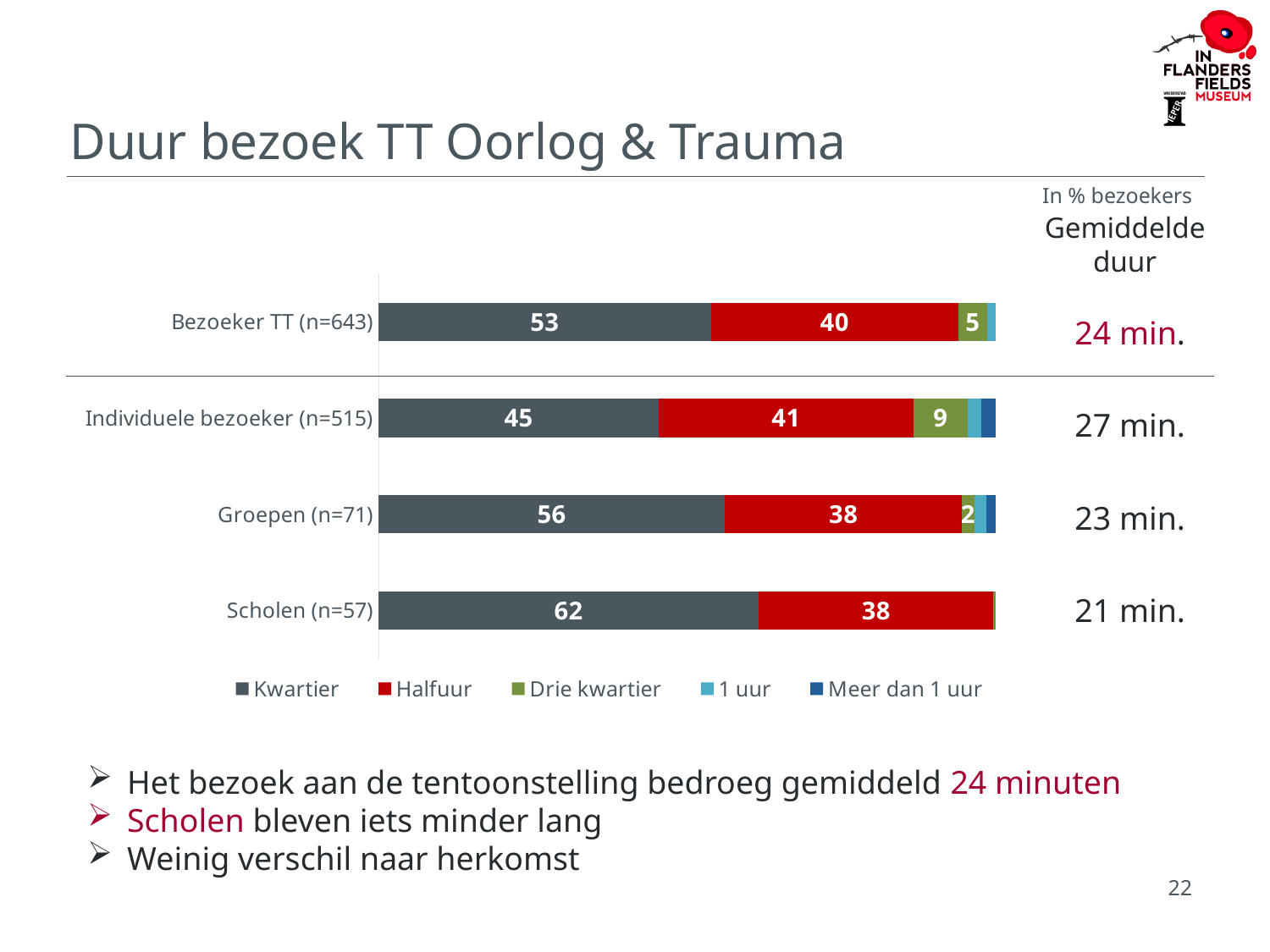
What kind of chart is shown on the slide? Stacked bar chart What is the Kwartier value for Bezoeker TT (n=643)? 53 What is the difference between the Kwartier values for Scholen (n=57) and Groepen (n=71)? 6 Which category has the lowest Kwartier value? Individuele bezoeker (n=515) Which is larger: the Halfuur value for Bezoeker TT (n=643) or the Halfuur value for Groepen (n=71)? Bezoeker TT (n=643) What is the Halfuur value for Individuele bezoeker (n=515)? 41 Which category has the highest Kwartier value? Scholen (n=57) Which legend entry is shown in red? Halfuur How many series does the legend list? 5 How many categories (visitor groups) are shown on the chart? 4 What is the Kwartier value for Scholen (n=57)? 62 What is the Drie kwartier value for Individuele bezoeker (n=515)? 9